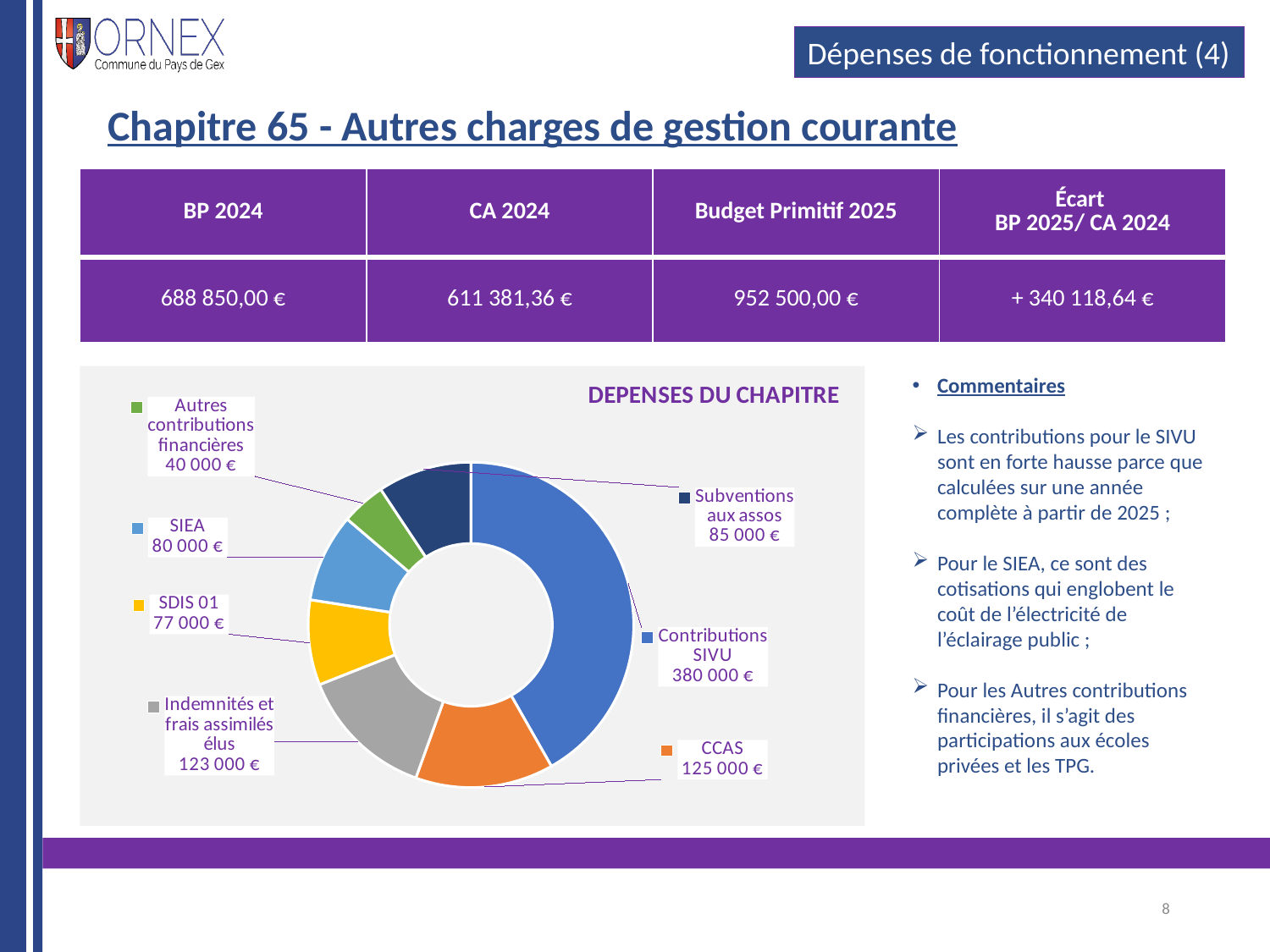
What is the title of the chart on the slide? DEPENSES DU CHAPITRE What is the value for CCAS in the DEPENSES DU CHAPITRE chart? 125 000 € What is the value for SDIS 01 in the DEPENSES DU CHAPITRE chart? 77 000 € What is the value for Contributions SIVU in the DEPENSES DU CHAPITRE chart? 380 000 € How many categories are shown in the DEPENSES DU CHAPITRE chart? 7 What kind of chart is DEPENSES DU CHAPITRE? Doughnut chart What is the difference between Contributions SIVU and CCAS in the DEPENSES DU CHAPITRE chart? 255 000 € Which category has the highest value in the DEPENSES DU CHAPITRE chart? Contributions SIVU In the DEPENSES DU CHAPITRE chart, which is larger: Subventions aux assos or Indemnités et frais assimilés élus? Indemnités et frais assimilés élus Which category has the lowest value in the DEPENSES DU CHAPITRE chart? Autres contributions financières What is the difference between SIEA and SDIS 01 in the DEPENSES DU CHAPITRE chart? 3 000 € What is the value for Autres contributions financières in the DEPENSES DU CHAPITRE chart? 40 000 €